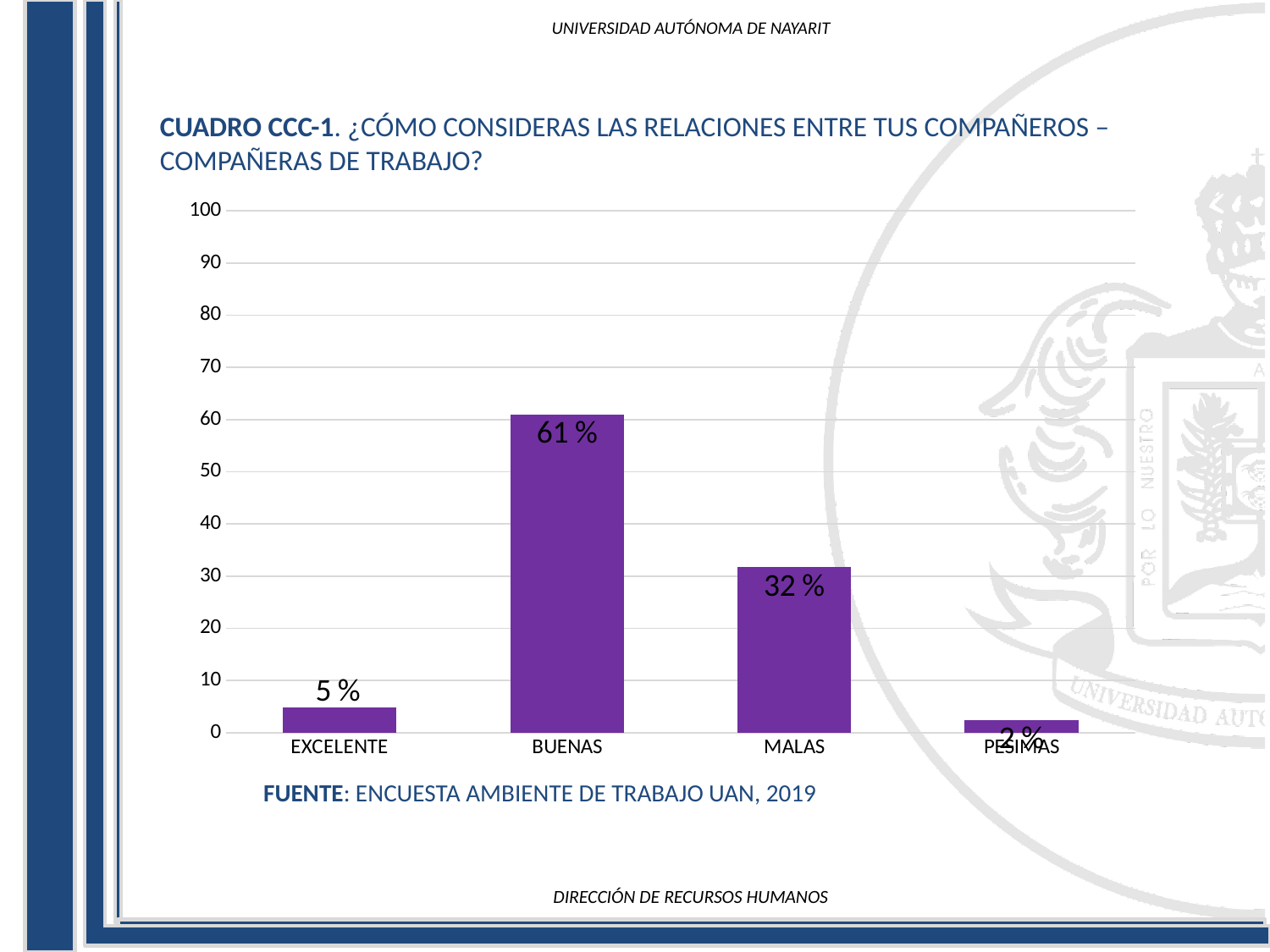
What kind of chart is shown on the slide? bar chart What is the difference between the values for BUENAS and MALAS? 29 % Which category has the highest value? BUENAS What is the value for BUENAS? 61 % Which is larger, the value for EXCELENTE or the value for MALAS? MALAS What is the value for MALAS? 32 % What is the difference between the values for MALAS and EXCELENTE? 27 % How many categories are shown on the x axis? 4 Is the value for BUENAS greater or less than 50? greater Which category has the lowest value? PESIMAS What source is cited below the chart? ENCUESTA AMBIENTE DE TRABAJO UAN, 2019 What is the value for EXCELENTE? 5 %